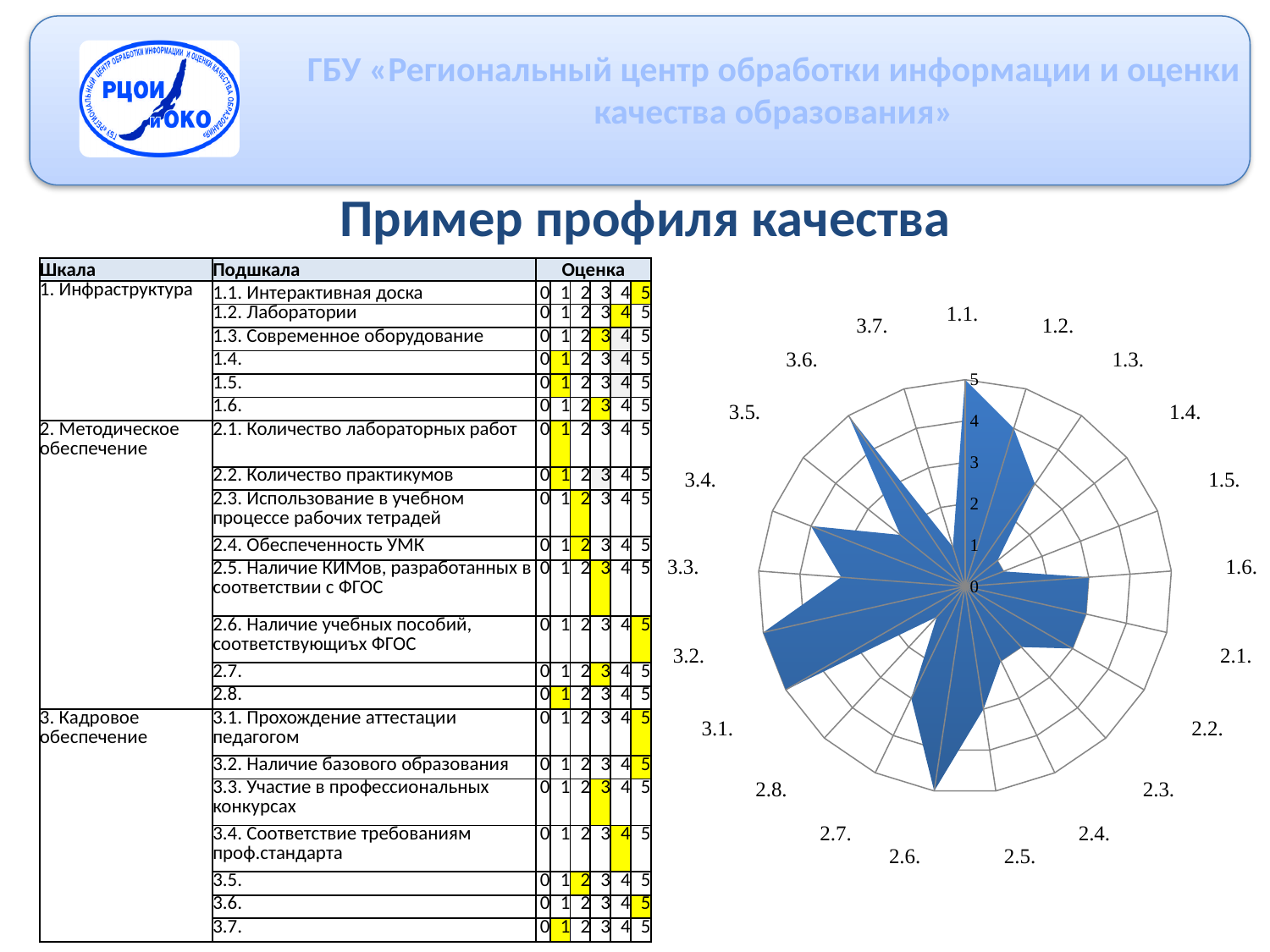
What is the value plotted for category 1.2 on the radar chart? 4 What is the value plotted for category 2.3 on the radar chart? 2 How many categories (subscales) are plotted around the radar chart? 21 Which is larger on the radar chart, the value for 1.1 or the value for 1.4? 1.1 What is the maximum value on the radar chart's scale? 5 What kind of chart is shown on the slide? radar chart What is the value plotted for category 2.6 on the radar chart? 5 What is the value plotted for category 1.1 on the radar chart? 5 What is the title of the slide above the chart? Пример профиля качества What is the difference between the values for 3.2 and 3.5 on the radar chart? 3 What is the value plotted for category 3.4 on the radar chart? 4